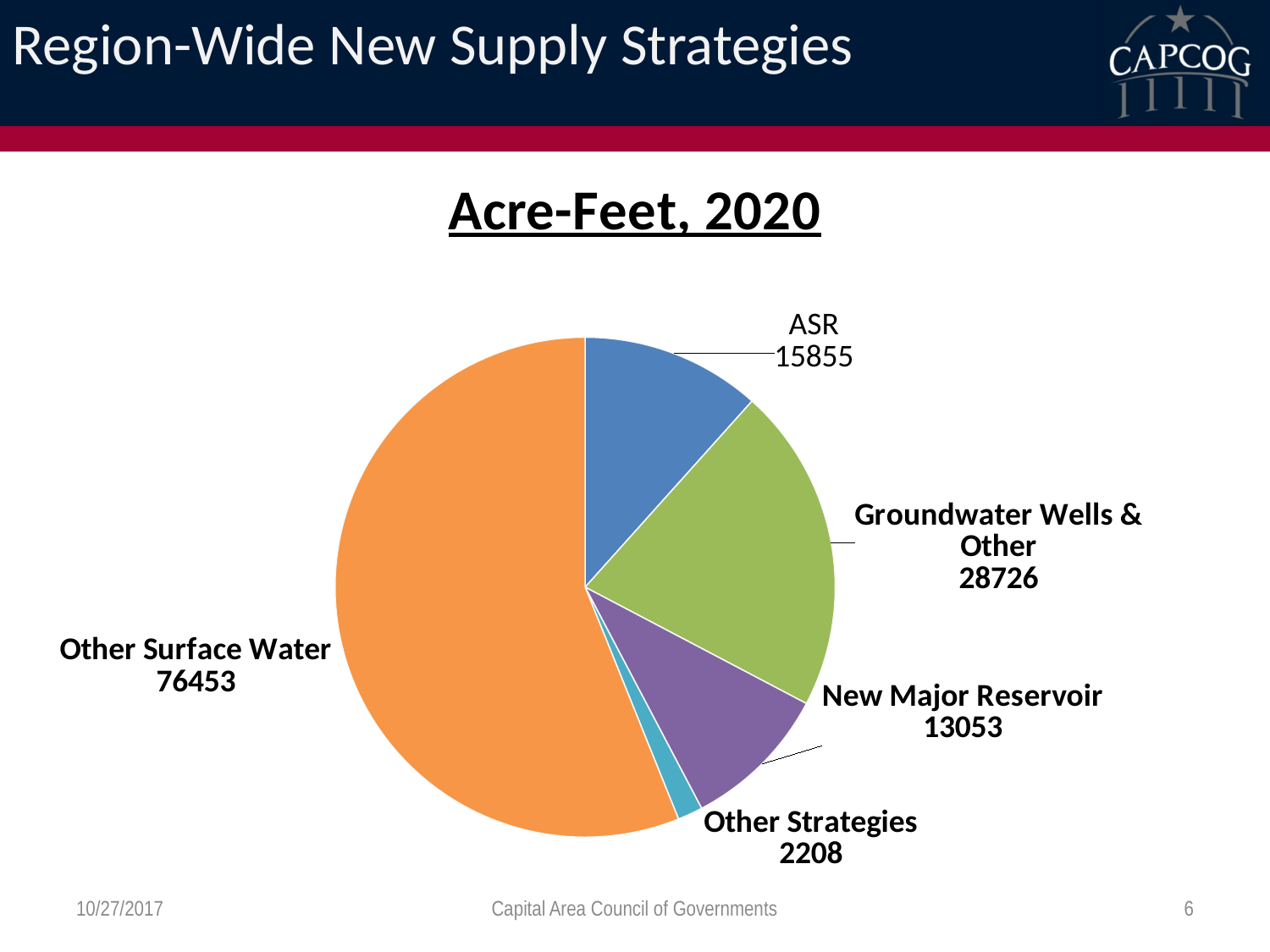
What is the difference between Other Surface Water and Groundwater Wells & Other? 47727 What is the value for Other Strategies? 2208 Which category has the largest slice? Other Surface Water What is the value for Other Surface Water? 76453 What type of chart is shown on the slide? Pie chart Which is larger, ASR or New Major Reservoir? ASR Which category has the smallest slice? Other Strategies How many slices does the pie chart have? 5 What is the value for Groundwater Wells & Other? 28726 What is the title of the chart? Acre-Feet, 2020 What is the value for ASR? 15855 What share of the pie does Other Surface Water represent? 56.1%